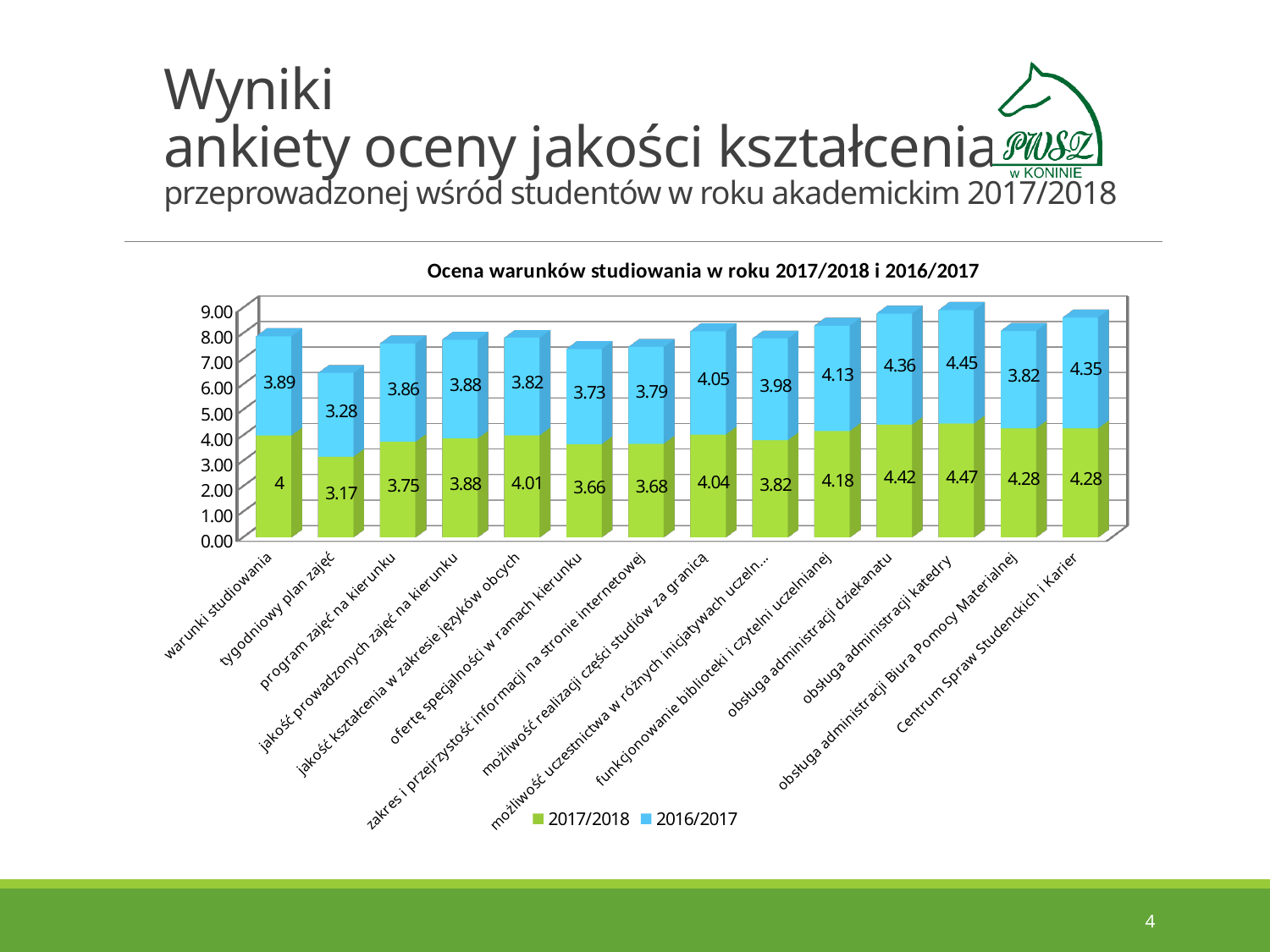
Which is larger for 'jakość kształcenia w zakresie języków obcych': the 2017/2018 value or the 2016/2017 value? 2017/2018 What type of chart is shown on the slide? Stacked bar chart How many categories are shown on the x axis? 14 What is the total of the stacked bar for 'tygodniowy plan zajęć'? 6.45 What is the difference between the 2017/2018 and 2016/2017 values for 'obsługa administracji Biura Pomocy Materialnej'? 0.46 How many series does the legend list? 2 What is the 2016/2017 value for 'obsługa administracji dziekanatu'? 4.36 Which category has the highest 2017/2018 value? obsługa administracji katedry What is the 2017/2018 value for 'obsługa administracji Biura Pomocy Materialnej'? 4.28 Which category has the lowest 2016/2017 value? tygodniowy plan zajęć What is the 2017/2018 value for 'tygodniowy plan zajęć'? 3.17 What is the total of the stacked bar for 'warunki studiowania'? 7.89